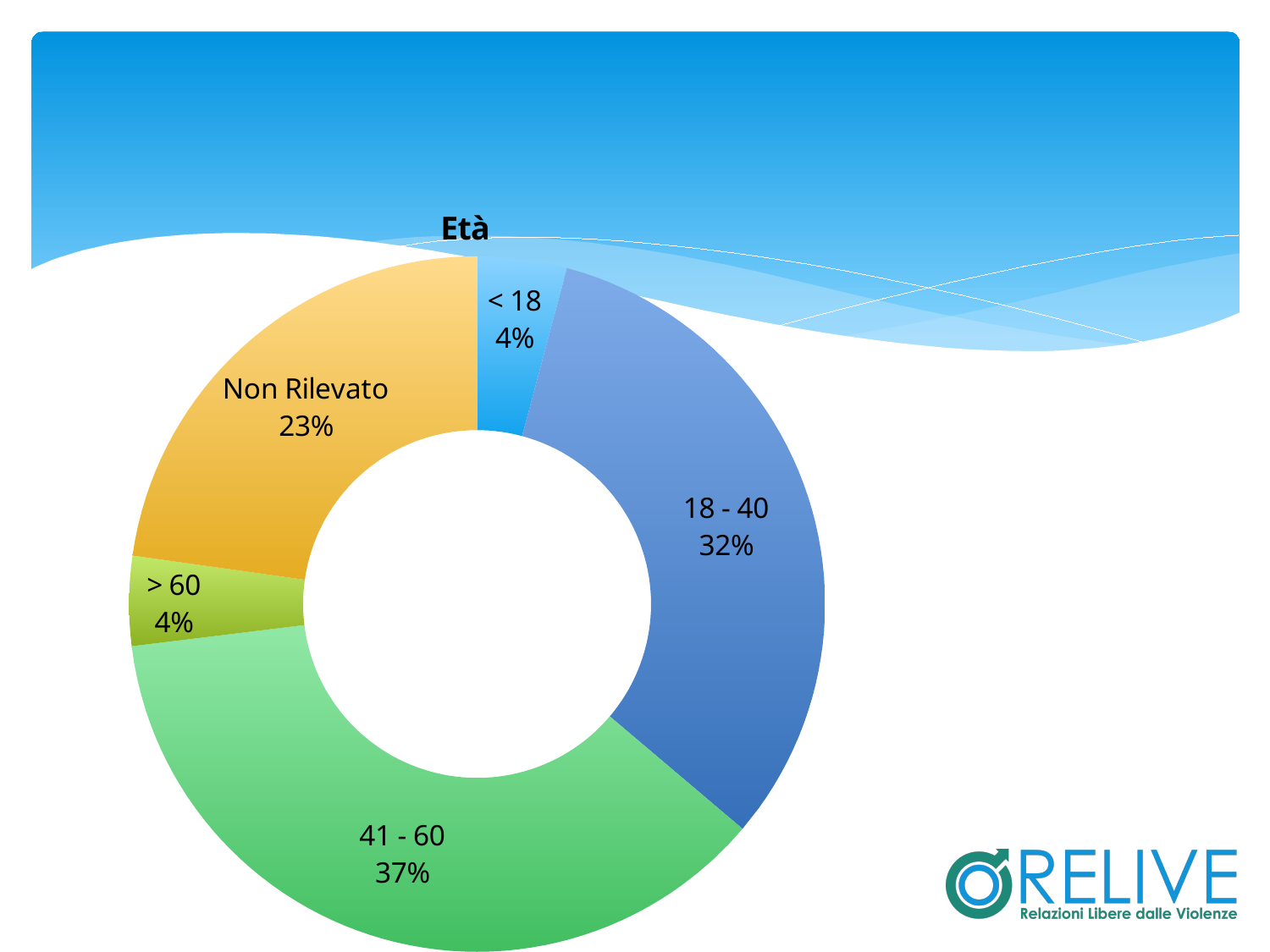
What share of the "Età" chart is the "Non Rilevato" slice? 23% What is the difference in percentage points between the "41 - 60" and "18 - 40" slices in the "Età" chart? 5 percentage points What is the difference in percentage points between the "Non Rilevato" and "< 18" slices in the "Età" chart? 19 percentage points Which category has the largest share in the "Età" chart among those above 10%: "18 - 40" or "Non Rilevato"? 18 - 40 What share of the "Età" chart is the "18 - 40" slice? 32% What share of the "Età" chart is the "< 18" slice? 4% Which category has the largest share in the "Età" chart? 41 - 60 What is the title of the chart on the slide? Età What kind of chart is the "Età" chart? Doughnut (pie) chart How many categories are shown in the "Età" chart? 5